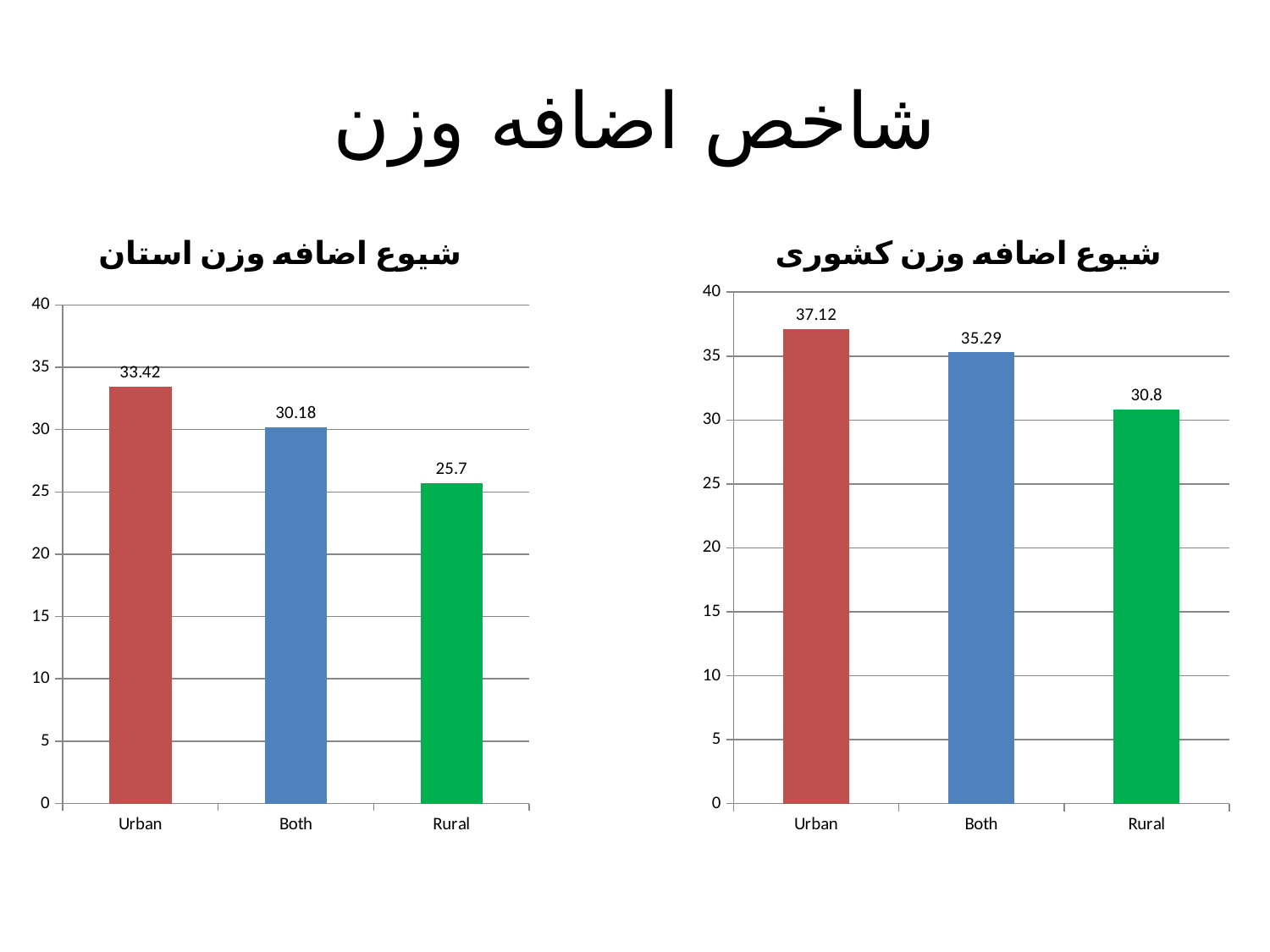
In the left chart (شیوع اضافه وزن استان), is the value for Both greater or less than 30? greater In the left chart (شیوع اضافه وزن استان), what is the value for Urban? 33.42 In the right chart (شیوع اضافه وزن کشوری), what is the difference between the Urban and Both values? 1.83 In the right chart (شیوع اضافه وزن کشوری), what is the value for Both? 35.29 What kind of chart is the left chart (شیوع اضافه وزن استان)? Bar chart In the right chart (شیوع اضافه وزن کشوری), what is the value for Rural? 30.8 In the right chart (شیوع اضافه وزن کشوری), which category has the highest value? Urban In the left chart (شیوع اضافه وزن استان), which category has the lowest value? Rural Which is larger: the Urban value in the left chart or the Urban value in the right chart? The right chart (37.12) In the left chart (شیوع اضافه وزن استان), what is the difference between the Urban and Rural values? 7.72 How many categories are shown in the right chart (شیوع اضافه وزن کشوری)? 3 In the right chart (شیوع اضافه وزن کشوری), do the values rise or fall from Urban to Rural? Fall